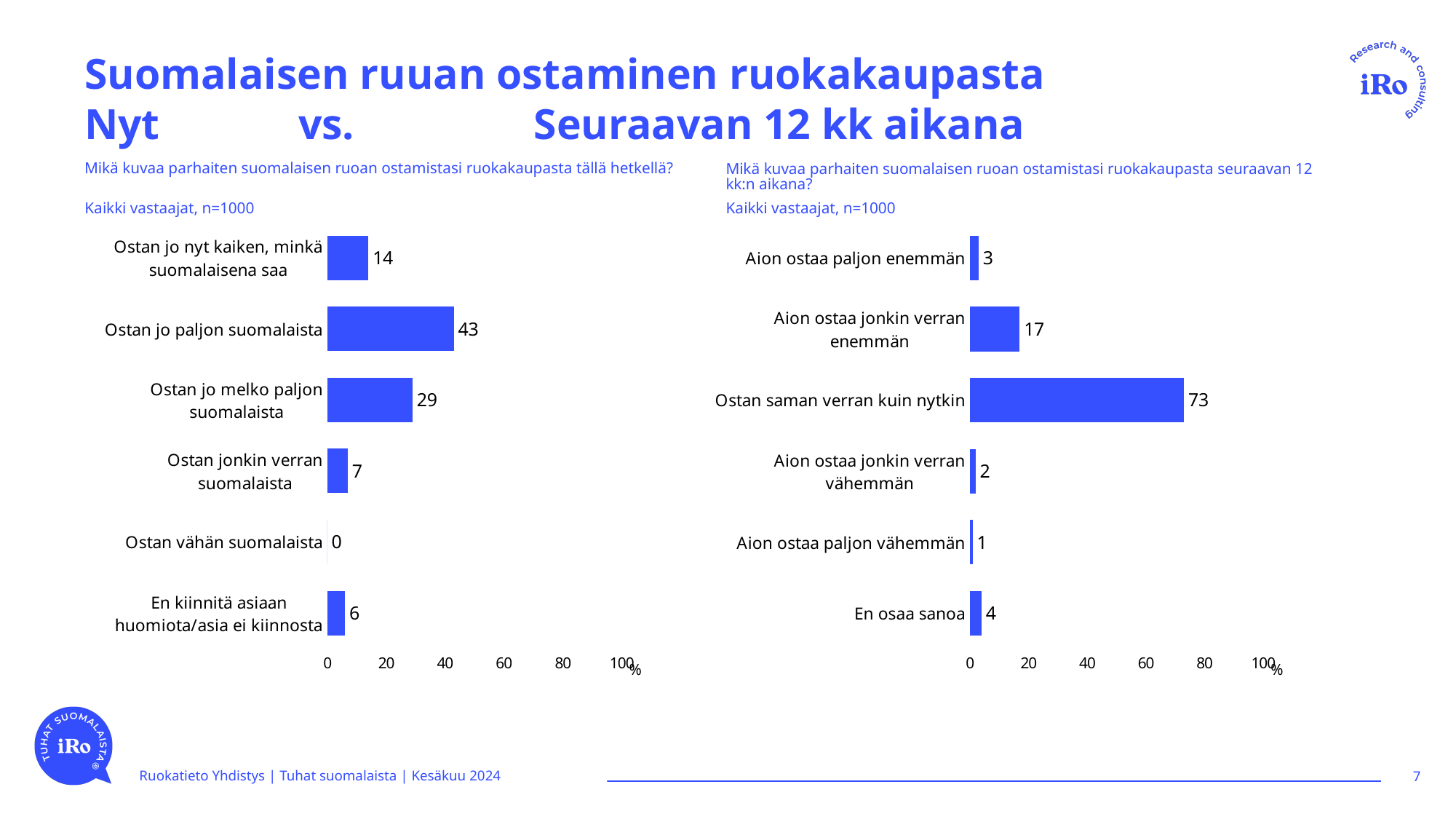
In the right chart (Seuraavan 12 kk aikana), which is larger: 'Aion ostaa paljon enemmän' or 'En osaa sanoa'? En osaa sanoa In the left chart (Nyt), how many categories are shown? 6 In the left chart (Nyt), what is the value for 'Ostan jonkin verran suomalaista'? 7 In the right chart (Seuraavan 12 kk aikana), what is the value for 'Aion ostaa jonkin verran enemmän'? 17 In the left chart (Nyt), which category has the lowest value? Ostan vähän suomalaista In the right chart (Seuraavan 12 kk aikana), what is the value for 'Ostan saman verran kuin nytkin'? 73 In the left chart (Nyt), which category has the highest value? Ostan jo paljon suomalaista What kind of chart is the left chart (Nyt)? bar chart In the left chart (Nyt), what is the value for 'Ostan jo paljon suomalaista'? 43 In the left chart (Nyt), what is the difference between 'Ostan jo paljon suomalaista' and 'Ostan jo melko paljon suomalaista'? 14 In the right chart (Seuraavan 12 kk aikana), which category has the lowest value? Aion ostaa paljon vähemmän In the right chart (Seuraavan 12 kk aikana), is the value for 'Ostan saman verran kuin nytkin' greater or less than 60? greater